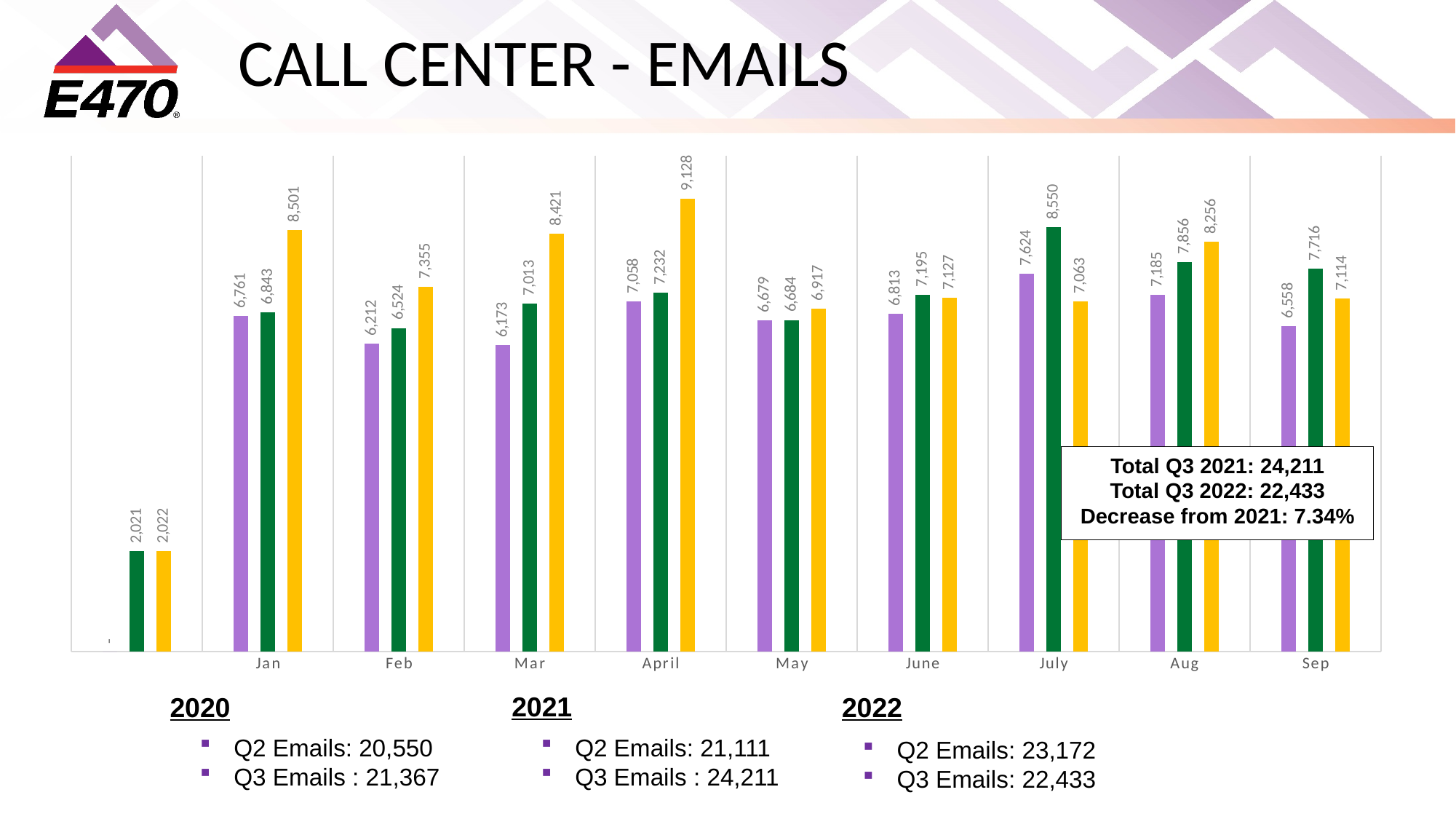
How many months are labelled on the x axis? 9 What kind of chart is shown on the slide? bar chart What is the value of the yellow bar for April? 9,128 What is the value of the green bar for July? 8,550 Do the purple bars rise or fall from Jan to Mar? fall What is the difference between the green bar and the yellow bar for July? 1,487 What is the value of the purple bar for Sep? 6,558 What is the difference between the yellow bar and the purple bar for April? 2,070 For June, which is larger, the green bar or the yellow bar? green bar In which month is the yellow bar highest? April In which month is the purple bar lowest? Mar What is the value of the purple bar for Feb? 6,212